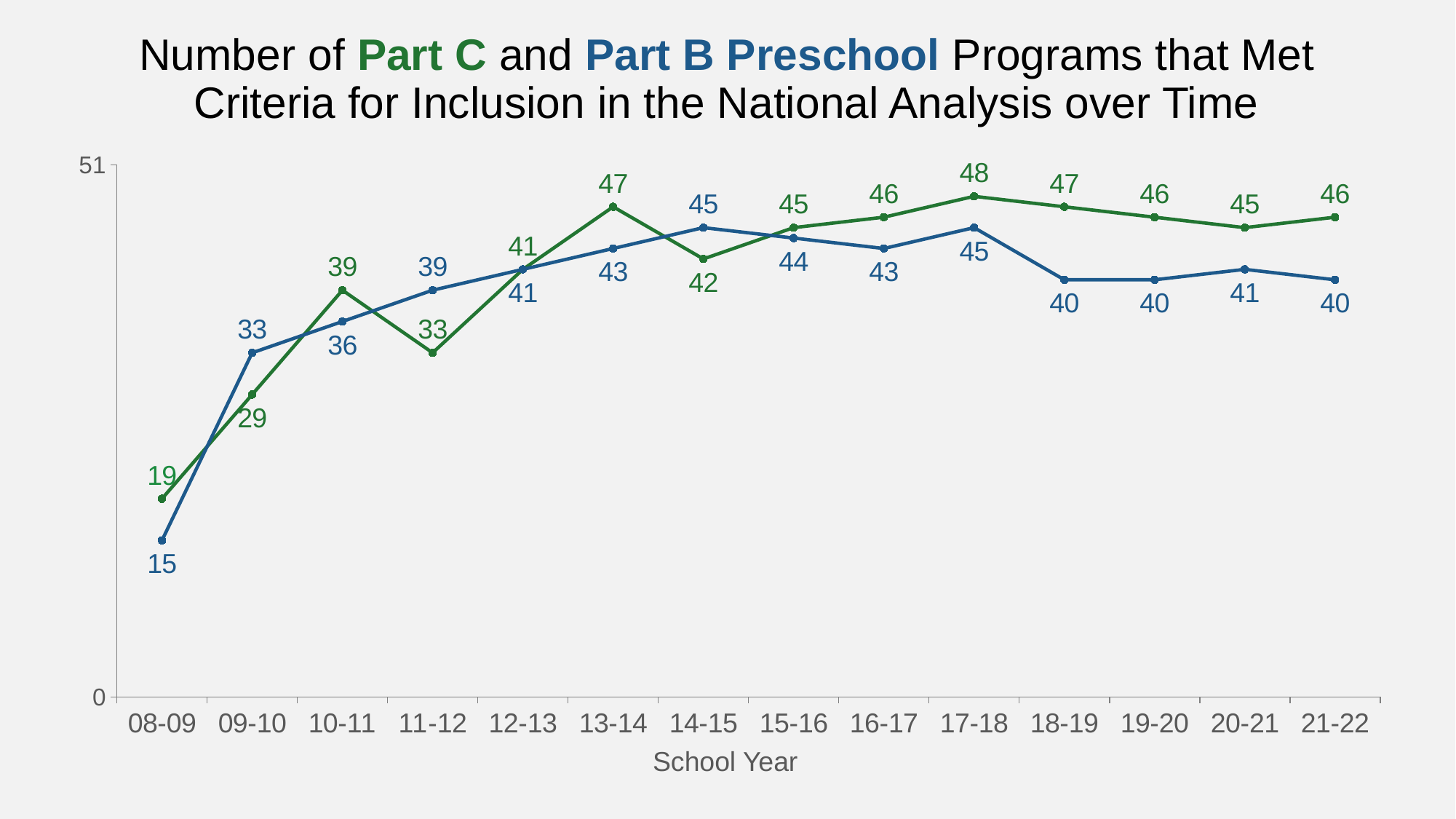
How many series are plotted on the chart? 2 What is the value for Part B Preschool in 17-18? 45 What is the label of the x axis? School Year What kind of chart is this? line chart What is the value for Part C in 13-14? 47 What is the difference between the Part C and Part B Preschool values in 21-22? 6 Which is larger in 11-12, Part C or Part B Preschool? Part B Preschool Does the Part B Preschool value rise or fall from 08-09 to 09-10? rise In which school year does Part C reach its highest value? 17-18 What is the value for Part C in 08-09? 19 In which school year is the Part B Preschool value lowest? 08-09 How many school years are shown on the x axis? 14